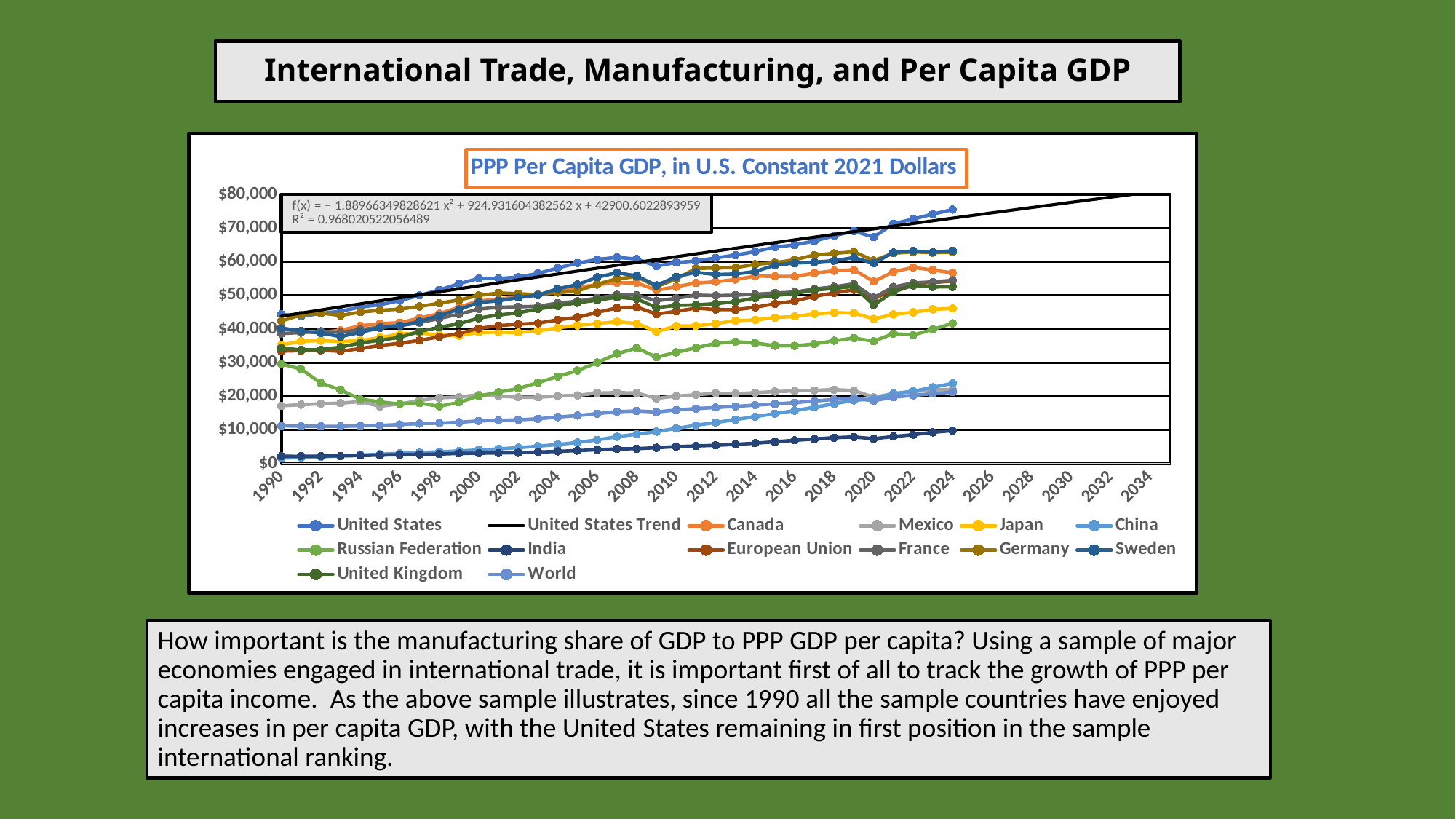
Which country has the lowest PPP per capita GDP in 2024? India What R² value is printed on the chart for the United States trend line? 0.968020522056489 In 2024, which is larger, the value for the United States or the value for Japan? United States Is the value for the United States in 2024 greater or less than $70,000? greater Is the value for China in 1990 greater or less than $10,000? less What kind of chart is shown on the slide? Line chart How many entries does the chart's legend list? 14 Does the United States series rise or fall from 1990 to 2024? Rise What is the title of the chart? PPP Per Capita GDP, in U.S. Constant 2021 Dollars Which country has the highest PPP per capita GDP in 2024? United States Is the value for Japan in 2024 greater or less than $50,000? less